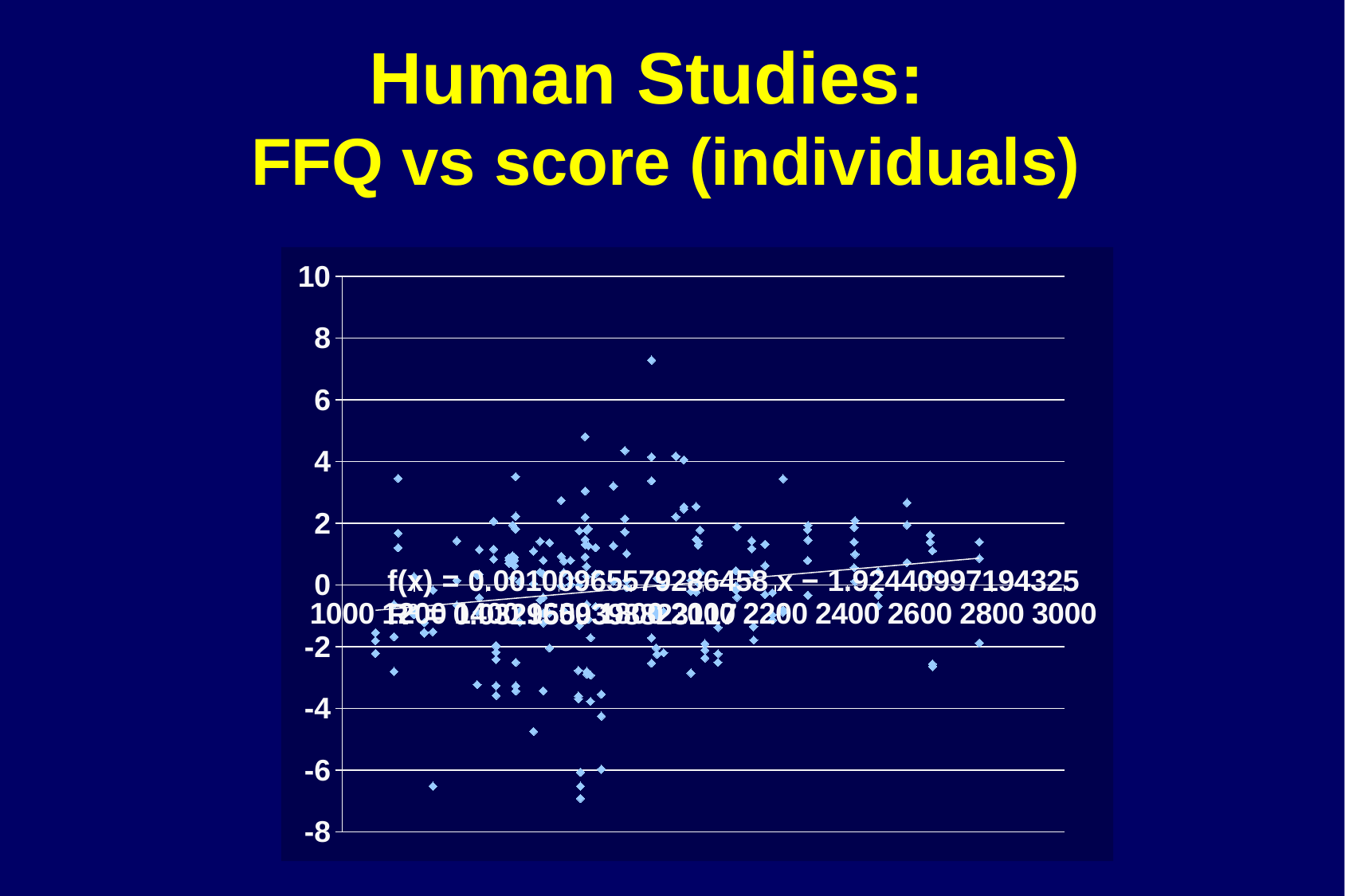
Does the fitted trendline in the chart rise or fall as x increases? rise What is the lowest value shown on the y axis of the chart? -8 What is the spacing between consecutive tick labels on the x axis of the chart? 200 Is the y value of the highest plotted point in the chart greater or less than 6? greater Is the y value of the lowest plotted point in the chart greater or less than -6? less What is the smallest value labelled on the x axis of the chart? 1000 What kind of chart is shown on the slide? scatter plot What is the slope coefficient of x in the trendline equation shown on the chart? 0.00100965579286458 What is the intercept in the trendline equation shown on the chart? −1.92440997194325